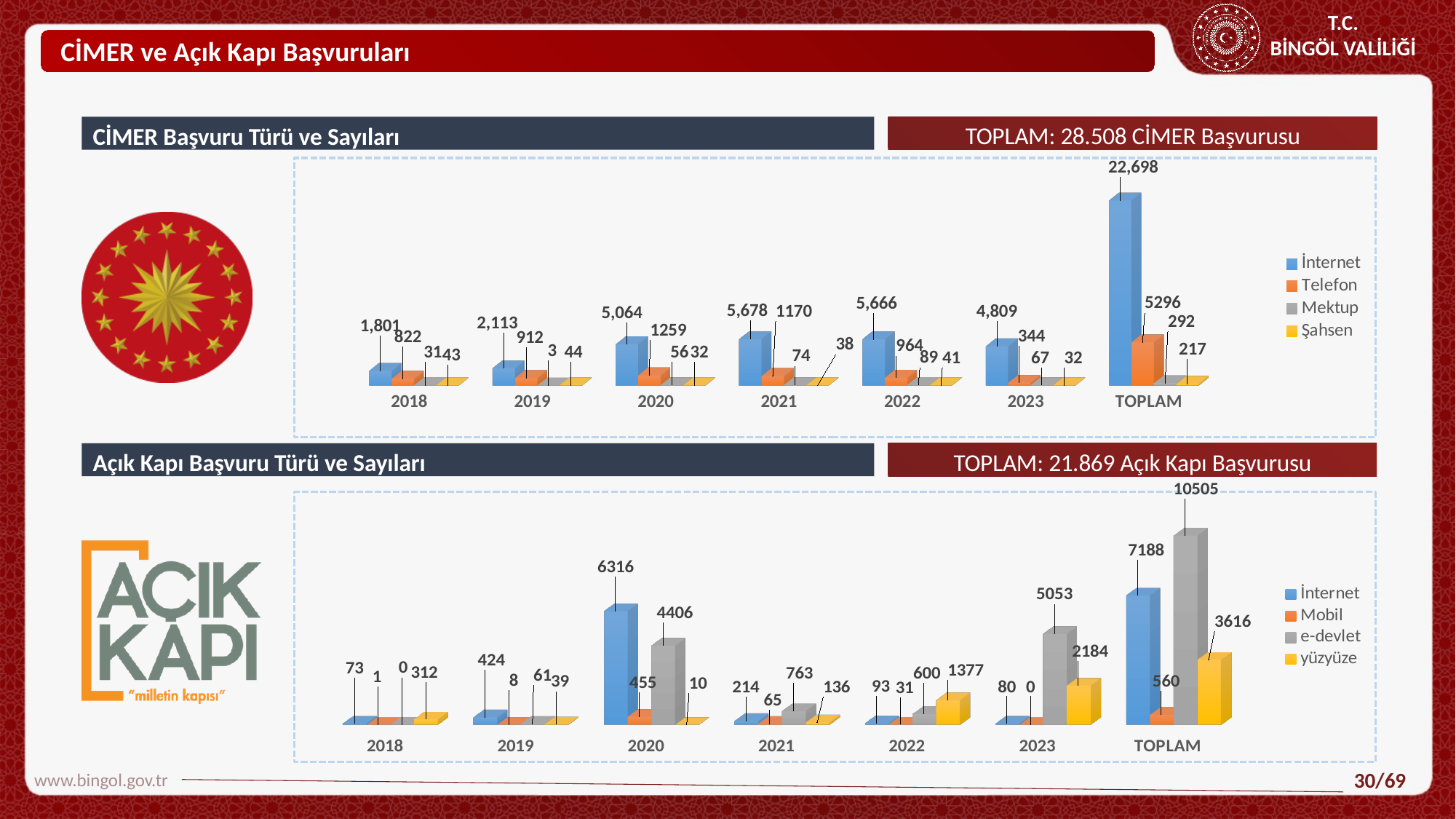
What type of chart is the Açık Kapı Başvuru Türü ve Sayıları chart? Bar chart In the CİMER Başvuru Türü ve Sayıları chart, what is the Telefon value for TOPLAM? 5296 In the Açık Kapı Başvuru Türü ve Sayıları chart, what is the yüzyüze value for 2022? 1377 In the Açık Kapı Başvuru Türü ve Sayıları chart, what is the difference between the İnternet and e-devlet values for 2020? 1910 In the CİMER Başvuru Türü ve Sayıları chart, which year has the highest İnternet value (excluding TOPLAM)? 2021 In the Açık Kapı Başvuru Türü ve Sayıları chart, what is the e-devlet value for 2023? 5053 In the CİMER Başvuru Türü ve Sayıları chart, what is the İnternet value for 2021? 5,678 In the CİMER Başvuru Türü ve Sayıları chart, which is larger: the Mektup value for 2022 or the Şahsen value for 2022? Mektup (89) In the Açık Kapı Başvuru Türü ve Sayıları chart, which series has the highest TOPLAM value? e-devlet In the CİMER Başvuru Türü ve Sayıları chart, how many series does the legend list? 4 In the CİMER Başvuru Türü ve Sayıları chart, what is the difference between the Telefon values for 2020 and 2023? 915 How many categories are shown on the x axis of the Açık Kapı Başvuru Türü ve Sayıları chart? 7